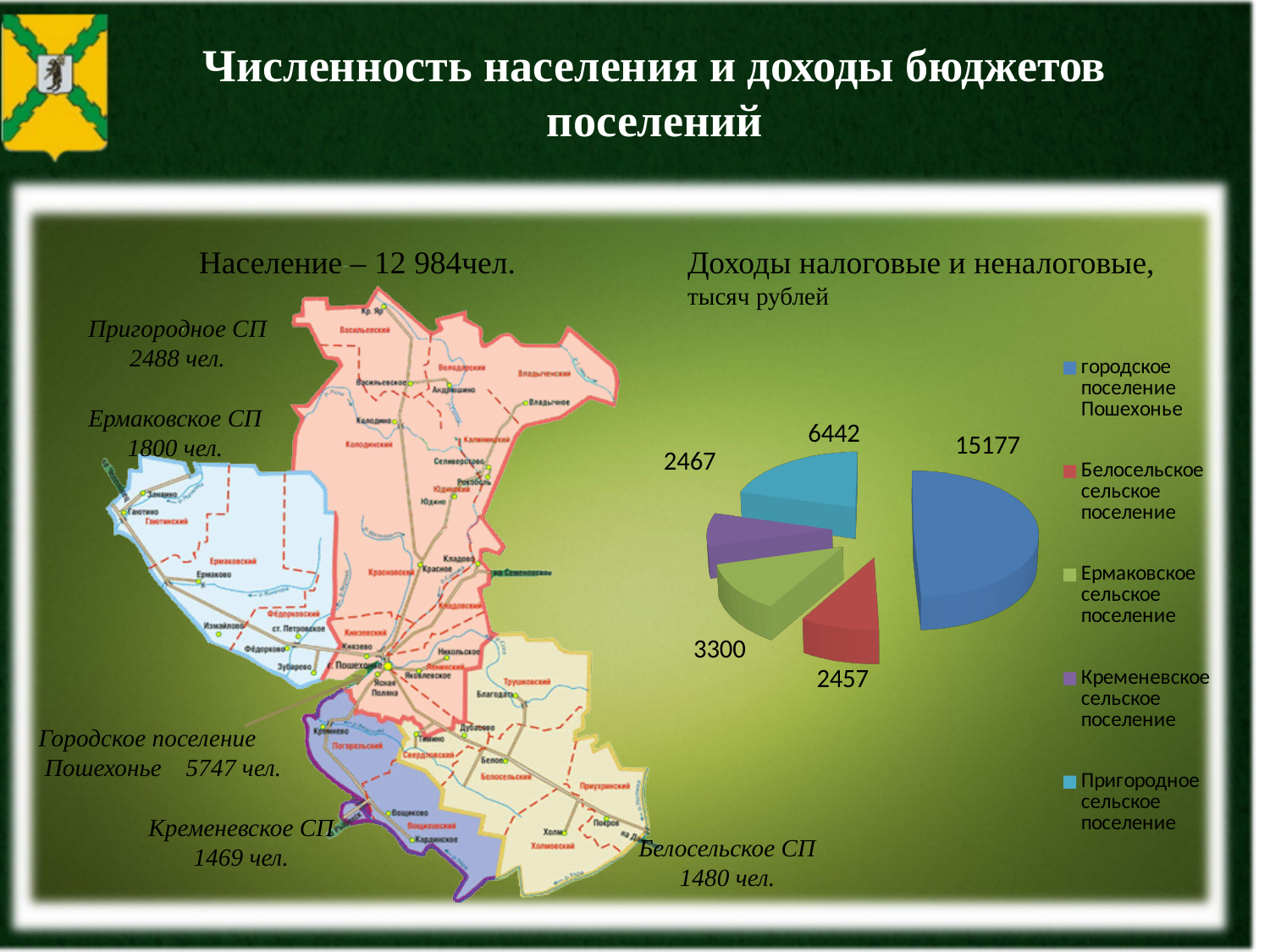
Which settlement has the smallest value in the pie chart? Белосельское сельское поселение In the pie chart, what is the value for городское поселение Пошехонье? 15177 In the pie chart, what is the value for Кременевское сельское поселение? 2467 What kind of chart is shown on the right side of the slide under the heading "Доходы налоговые и неналоговые, тысяч рублей"? Pie chart In the pie chart, what is the difference between the values for городское поселение Пошехонье and Пригородное сельское поселение? 8735 In the pie chart, what is the value for Ермаковское сельское поселение? 3300 What is the total of all the values shown in the pie chart? 29843 How many entries does the legend of the pie chart list? 5 In the pie chart, what is the value for Белосельское сельское поселение? 2457 In the pie chart, what is the value for Пригородное сельское поселение? 6442 In the pie chart, which is larger: the value for Ермаковское сельское поселение or for Пригородное сельское поселение? Пригородное сельское поселение Which settlement has the largest slice in the pie chart? городское поселение Пошехонье